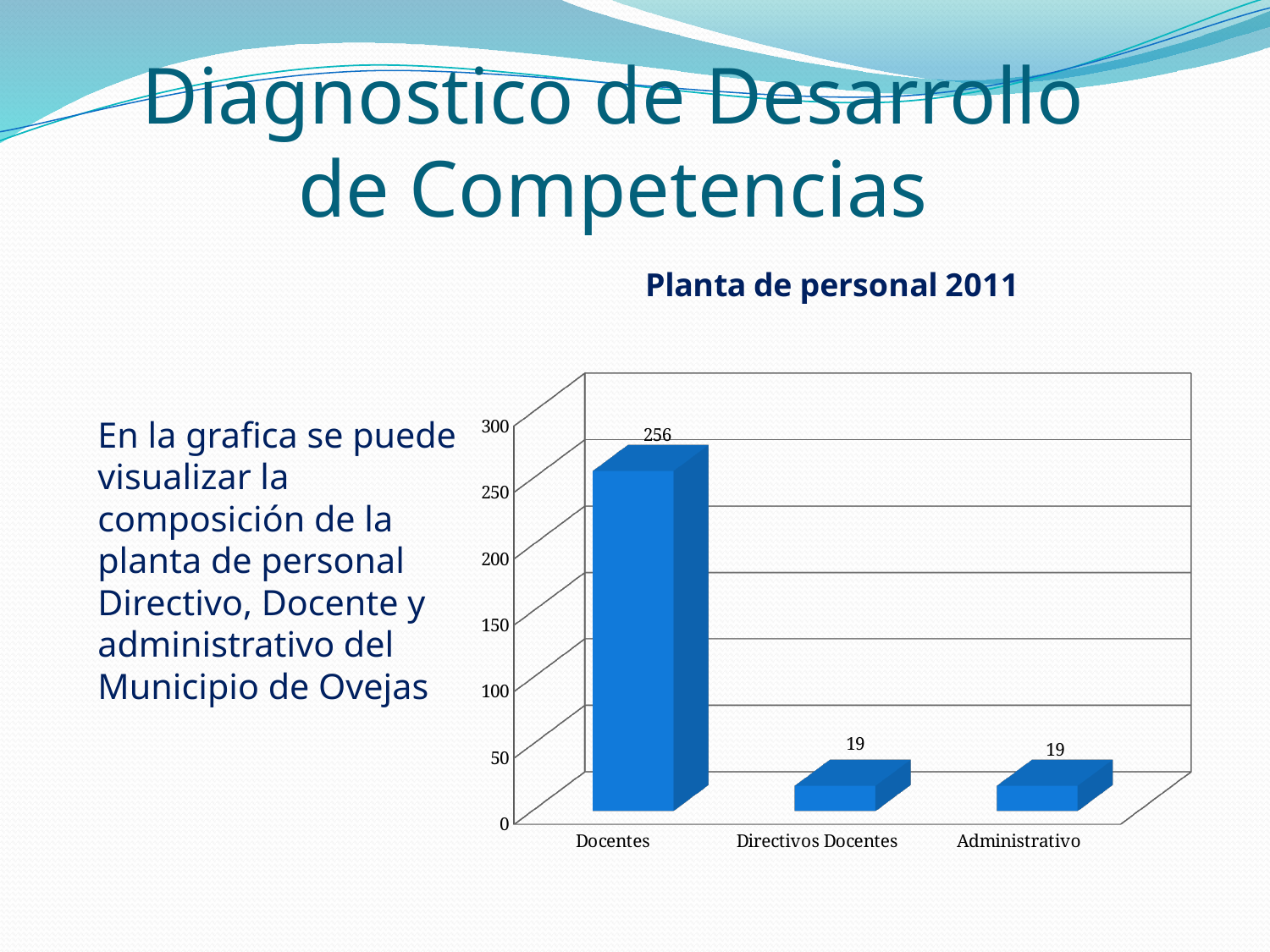
What is the title of the chart? Planta de personal 2011 What is the value for Directivos Docentes? 19 What is the value for Docentes? 256 What is the difference between the values for Docentes and Administrativo? 237 Which category has the highest value? Docentes What is the value for Administrativo? 19 What kind of chart is shown on the slide? bar chart What is the total of the three values shown in the chart? 294 Is the value for Administrativo greater or less than 50? less How many categories are shown on the x axis? 3 Is the value for Docentes greater or less than 250? greater Which is larger, the value for Docentes or the value for Directivos Docentes? Docentes